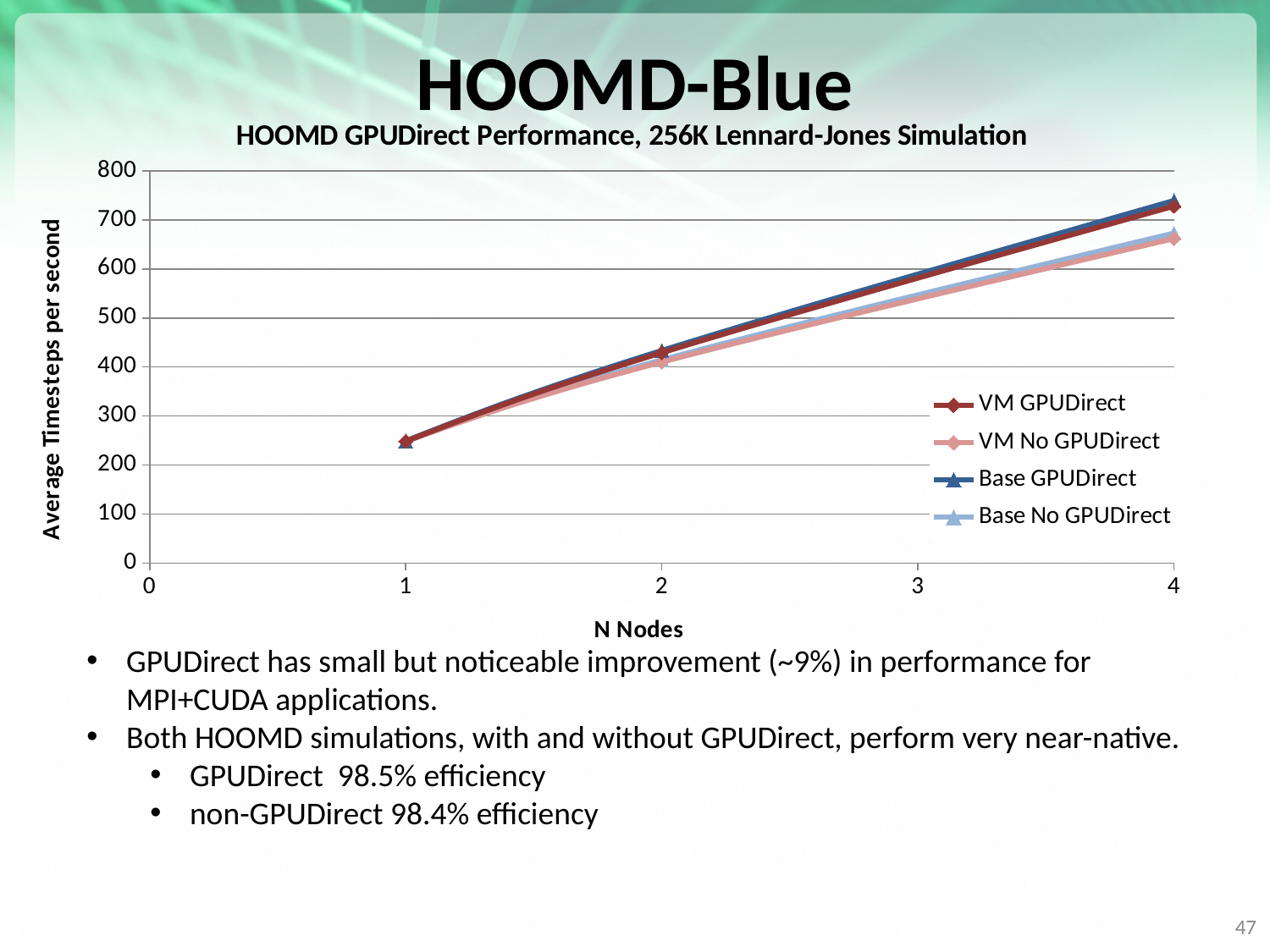
Is the value for Base GPUDirect at 1 node greater or less than 300? less Is the value for Base GPUDirect at 4 nodes greater or less than 700? greater At 4 nodes, which is larger: Base GPUDirect or Base No GPUDirect? Base GPUDirect How many data points are plotted for the VM GPUDirect series? 3 Is the value for VM GPUDirect at 2 nodes greater or less than 400? greater Do the values for Base GPUDirect rise or fall as N Nodes increases? rise What is the label of the y axis? Average Timesteps per second What kind of chart is shown on the slide? line chart How many series does the legend list? 4 At 4 nodes, which is larger: VM GPUDirect or VM No GPUDirect? VM GPUDirect What is the title of the chart? HOOMD GPUDirect Performance, 256K Lennard-Jones Simulation